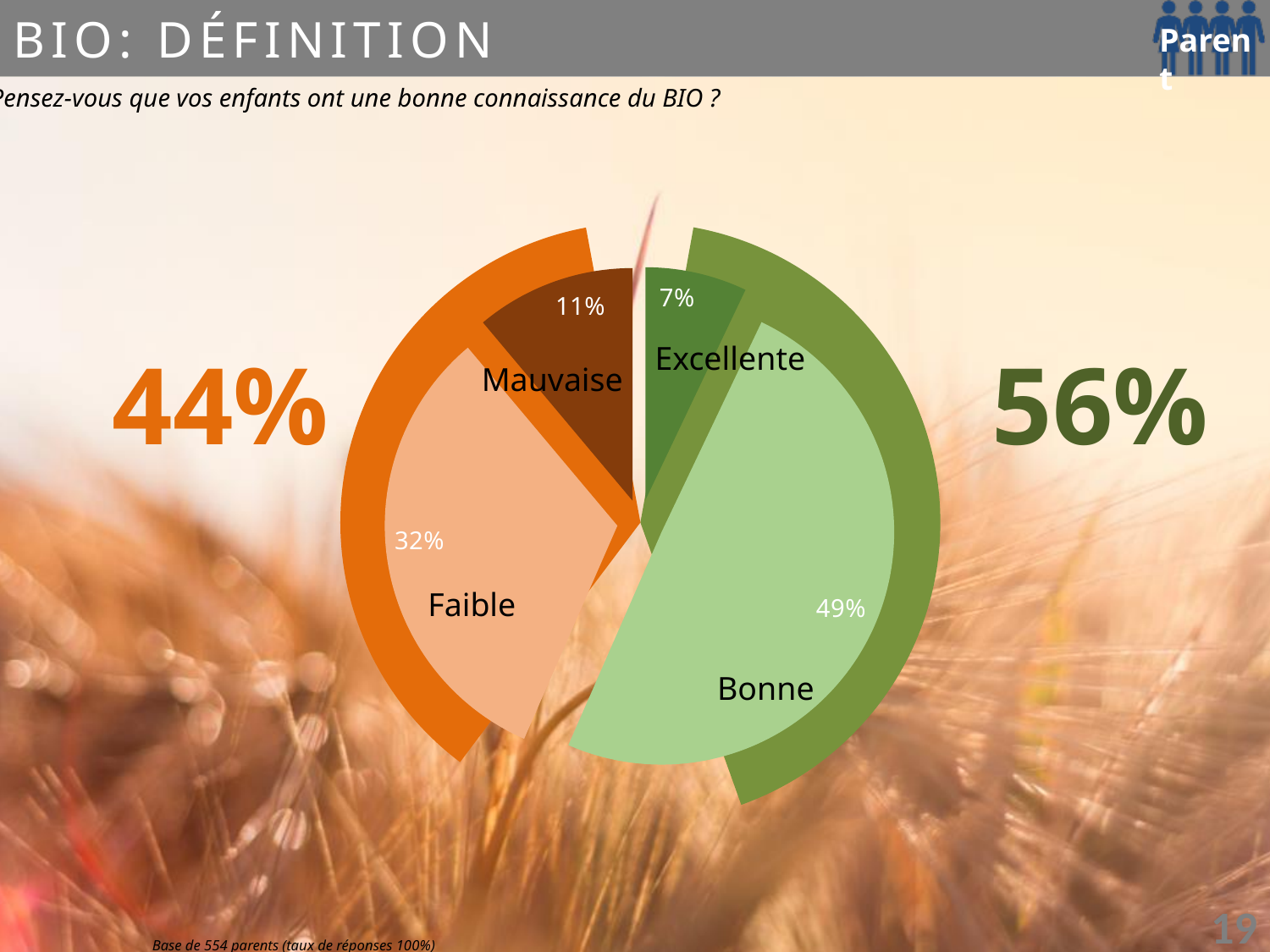
What percentage of parents answered "Bonne"? 49% What percentage of parents answered "Mauvaise"? 11% What combined percentage is shown in green to the right of the pie for the positive responses (Bonne and Excellente)? 56% Which response category has the smallest share of the pie? Excellente What is the difference in percentage points between "Bonne" and "Faible"? 17 Which is larger, the share for "Mauvaise" or the share for "Excellente"? Mauvaise What combined percentage is shown in orange to the left of the pie for the negative responses (Faible and Mauvaise)? 44% What percentage of parents answered "Excellente"? 7% What percentage of parents answered "Faible"? 32% How many slices does the pie chart have? 4 Which response category has the largest share of the pie? Bonne What kind of chart is shown on the slide? pie chart